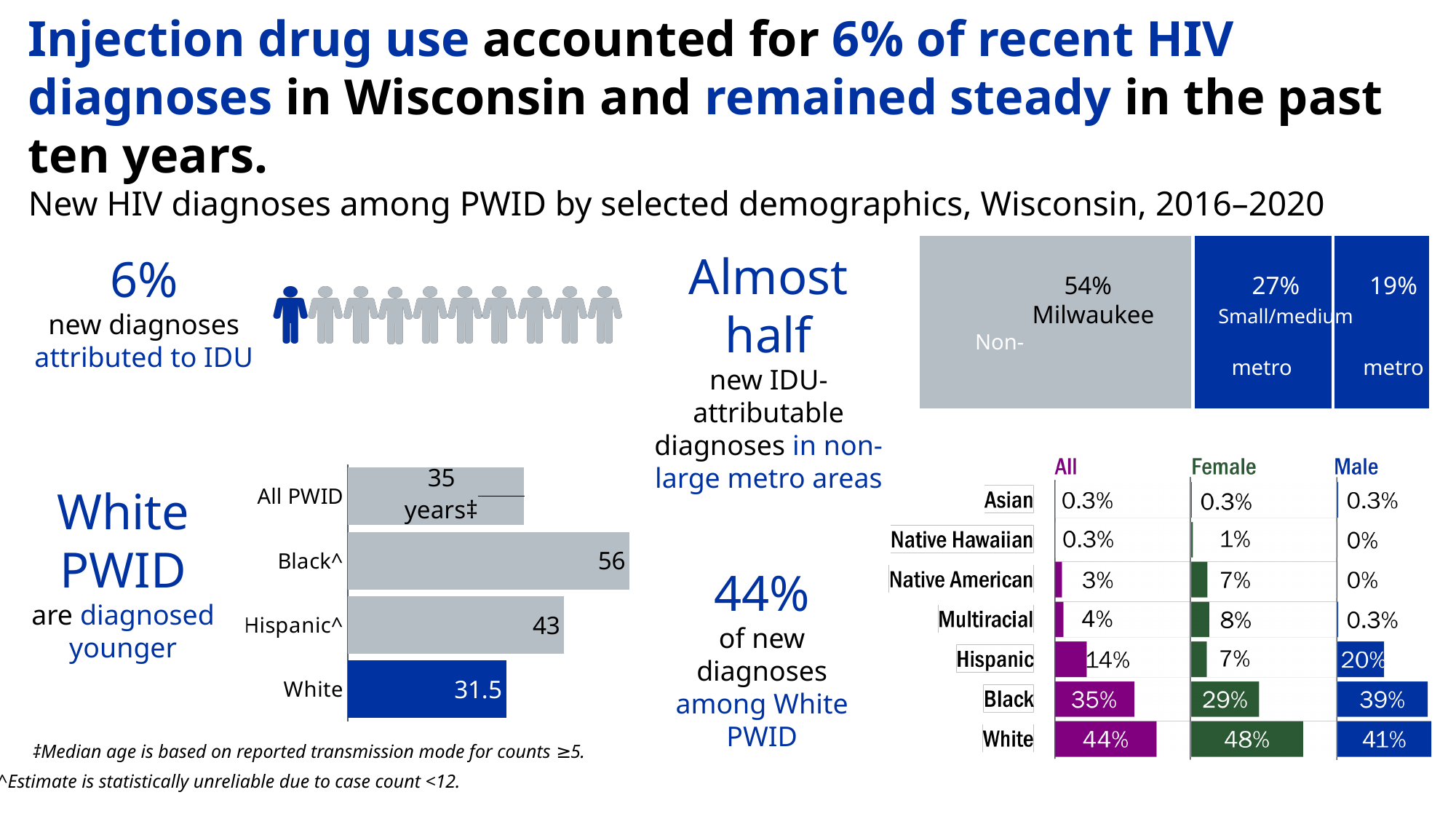
In the metro area bar at the top right, what percentage of new IDU-attributable diagnoses is shown for Milwaukee? 54% In the median age bar chart, what is the difference between the median age for Black^ PWID and Hispanic^ PWID? 13 In the median age bar chart, which group has the highest median age? Black^ In the median age bar chart, what is the median age for White PWID? 31.5 In the race/ethnicity chart on the right, how many series are shown (All, Female, Male)? 3 In the median age bar chart, which group has the lowest median age? White What kind of chart is the median age chart on the left? Bar chart In the race/ethnicity chart on the right, what share of new diagnoses among Female PWID is White? 48% In the race/ethnicity chart on the right, which is larger for Black PWID: the Female share or the Male share? Male In the median age bar chart, how many groups are shown? 4 In the race/ethnicity chart on the right, what share of new diagnoses among Male PWID is Hispanic? 20% In the median age bar chart, what is the median age for Black^ PWID? 56